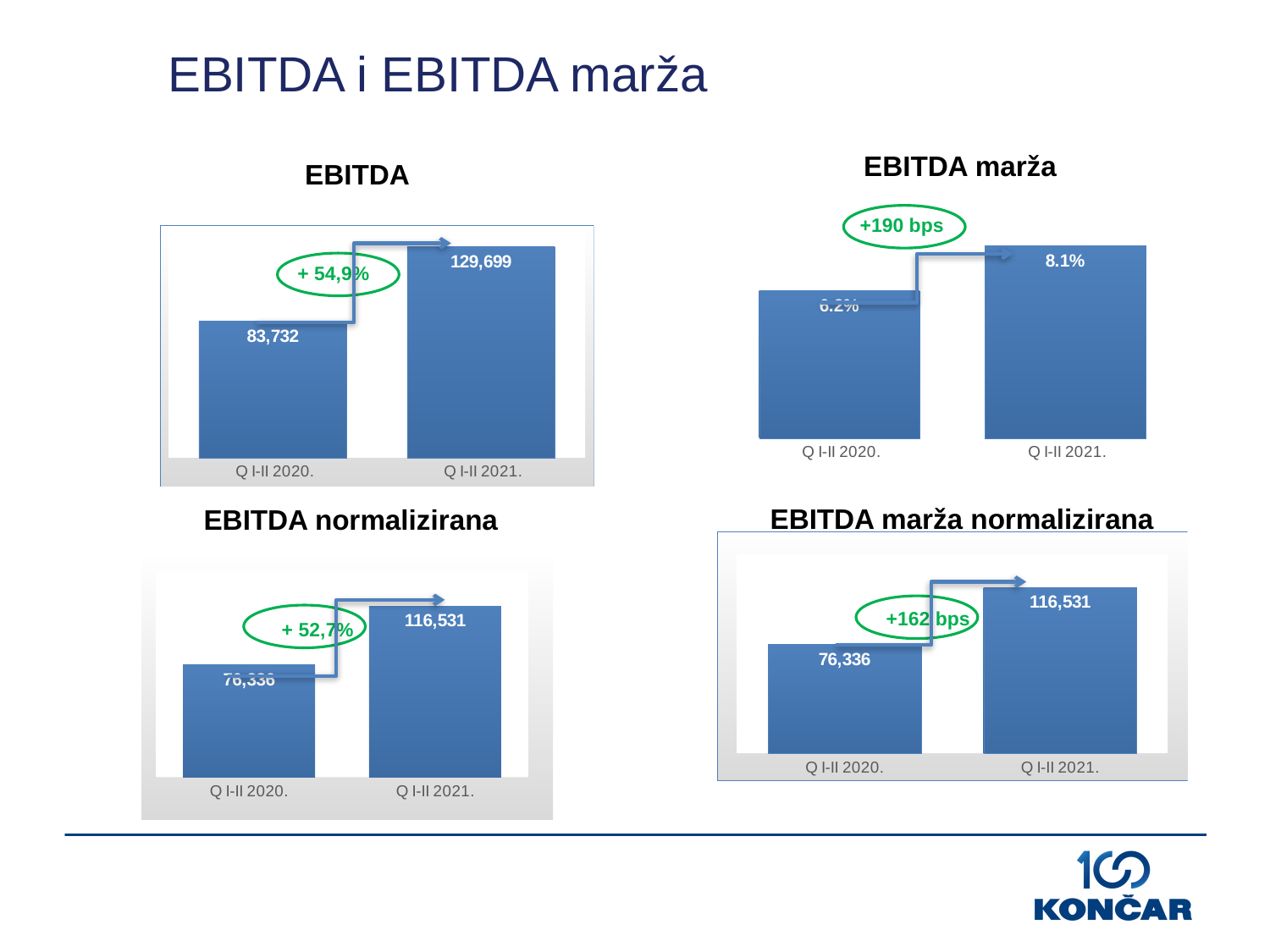
In the EBITDA normalizirana chart, what is the value for Q I-II 2021.? 116,531 In the EBITDA marža normalizirana chart, what is the difference between the Q I-II 2021. and Q I-II 2020. values? 40,195 In the EBITDA marža chart, what change in basis points is shown in the green oval? +190 bps In the EBITDA marža chart, which period has the higher value? Q I-II 2021. In the EBITDA chart, what percentage change is shown in the green oval? + 54,9% In the EBITDA chart, what is the value for Q I-II 2020.? 83,732 In the EBITDA chart, what is the difference between the Q I-II 2021. and Q I-II 2020. values? 45,967 How many categories are shown on the x axis of the EBITDA normalizirana chart? 2 In the EBITDA marža normalizirana chart, what is the value for Q I-II 2020.? 76,336 In the EBITDA chart, what is the value for Q I-II 2021.? 129,699 What type of chart is the EBITDA chart? Bar chart In the EBITDA marža chart, what is the value for Q I-II 2021.? 8.1%